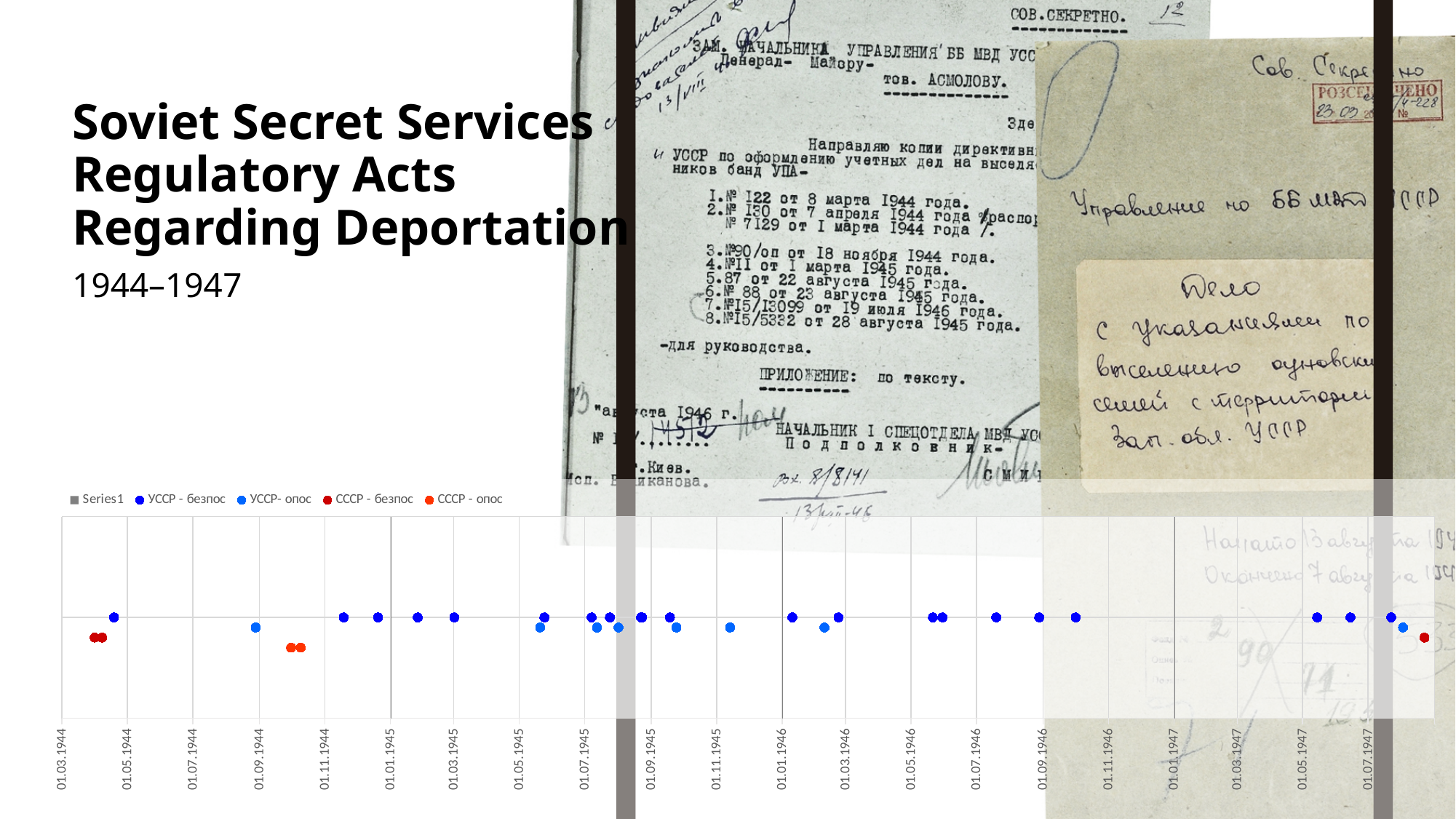
Which series has the most points plotted on the chart? УССР - безпос What kind of chart is shown on the slide? scatter chart How many points are plotted for the series 'СССР - безпос' (dark red)? 3 How many points are plotted for the series 'СССР - опос' (orange)? 2 What is the first entry in the chart legend? Series1 How many series does the chart legend list? 5 What is the earliest date label shown on the x axis of the chart? 01.03.1944 What colour are the points of the series 'УССР - безпос'? dark blue Which series has more plotted points, 'УССР - безпос' or 'СССР - опос'? УССР - безпос